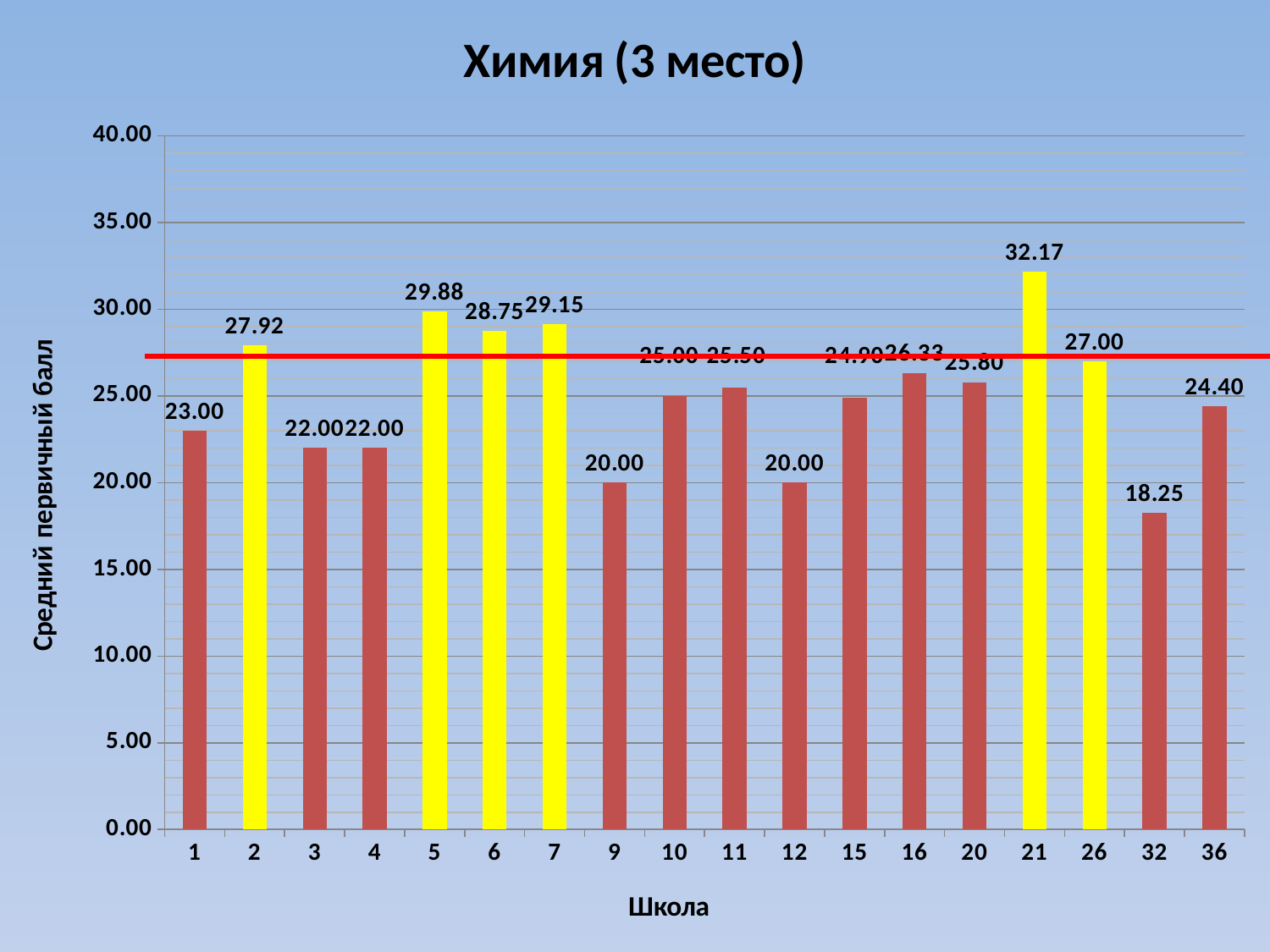
What is the value for school 21? 32.17 What is the value for school 36? 24.40 How many schools are shown on the x axis? 18 Is the value for school 9 greater or less than 25.00? less Which has a larger value, school 6 or school 7? 7 Which school has the highest average score? 21 What is the difference between the values for school 2 and school 26? 0.92 Which school has the lowest average score? 32 What is the value for school 5? 29.88 What is the difference between the values for school 21 and school 32? 13.92 What is the title of the chart? Химия (3 место) What kind of chart is this? bar chart